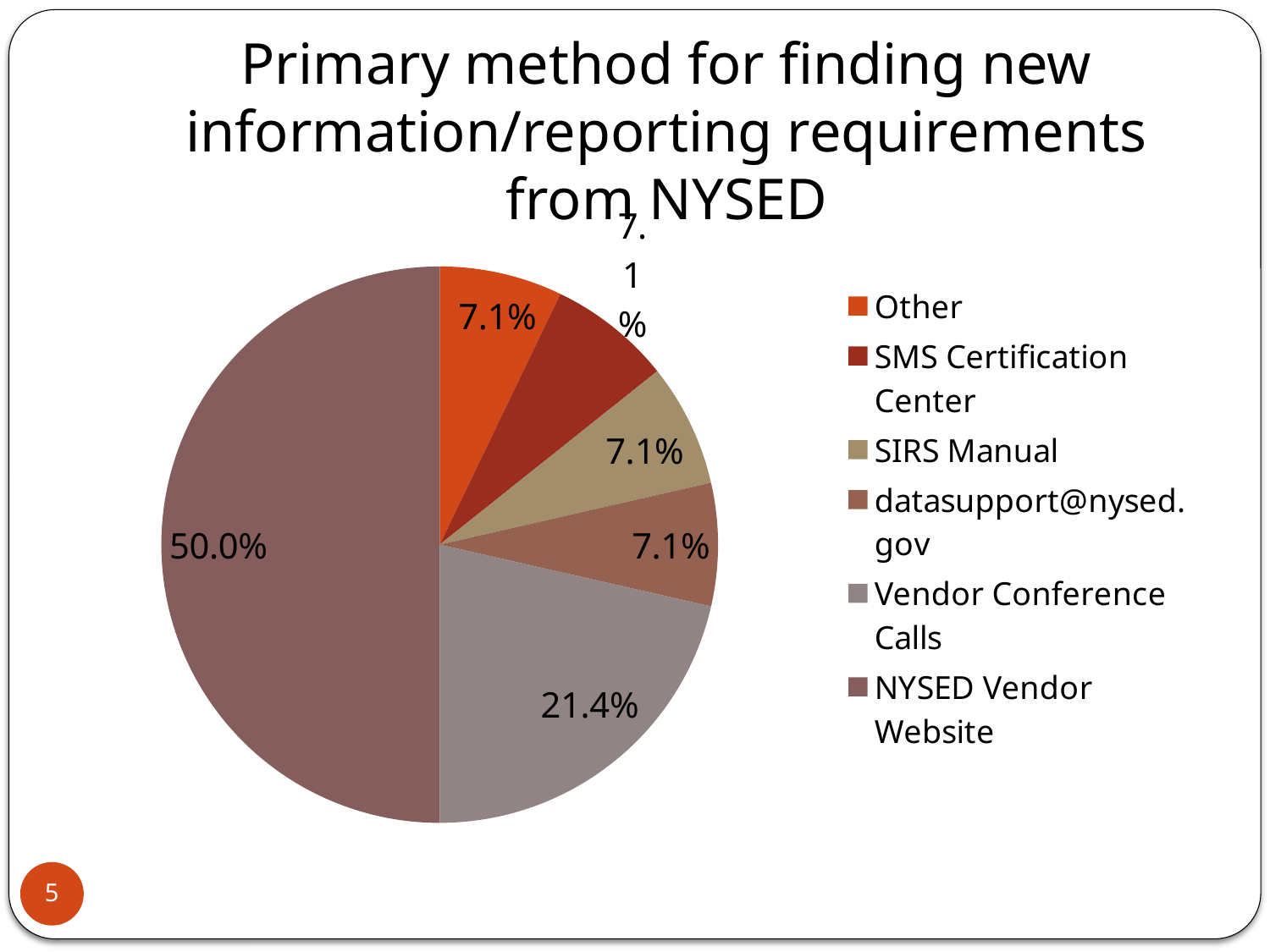
How many categories does the legend list? 6 What is the value for datasupport@nysed.gov? 7.1% What share of the pie does Vendor Conference Calls have? 21.4% What kind of chart is shown on the slide? pie chart Which legend entry is shown in orange? Other What share of the pie does NYSED Vendor Website have? 50.0% What is the title of the chart? Primary method for finding new information/reporting requirements from NYSED Which category has the largest slice of the pie? NYSED Vendor Website Which is larger, the slice for Vendor Conference Calls or the slice for SIRS Manual? Vendor Conference Calls What is the value for Other? 7.1% What is the difference between the NYSED Vendor Website share and the Vendor Conference Calls share? 28.6% What is the value for SIRS Manual? 7.1%